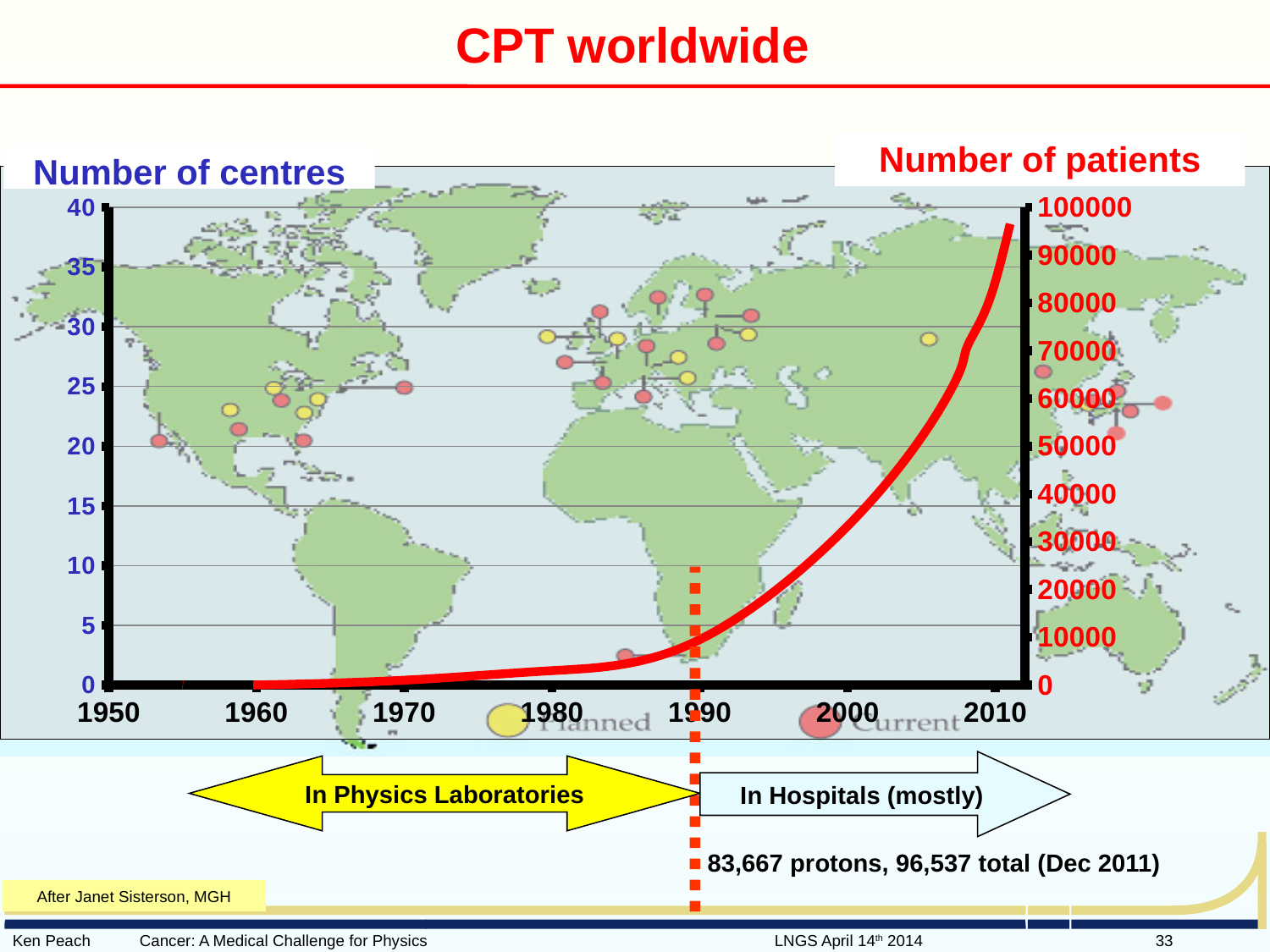
Is the number of patients at the end of the red curve (around 2011) greater or less than 90000? greater Is the number of patients in 2000 greater or less than 20000? greater What is the last year labelled on the x axis? 2010 What is the highest value shown on the left-hand 'Number of centres' axis? 40 What kind of chart is overlaid on the world map? line chart What is the first year labelled on the x axis? 1950 Does the red curve for number of patients rise or fall from 1950 to 2010? rise How many year labels are shown along the x axis? 7 Is the number of patients in 1990 greater or less than 20000? less What is the highest value shown on the right-hand 'Number of patients' axis? 100000